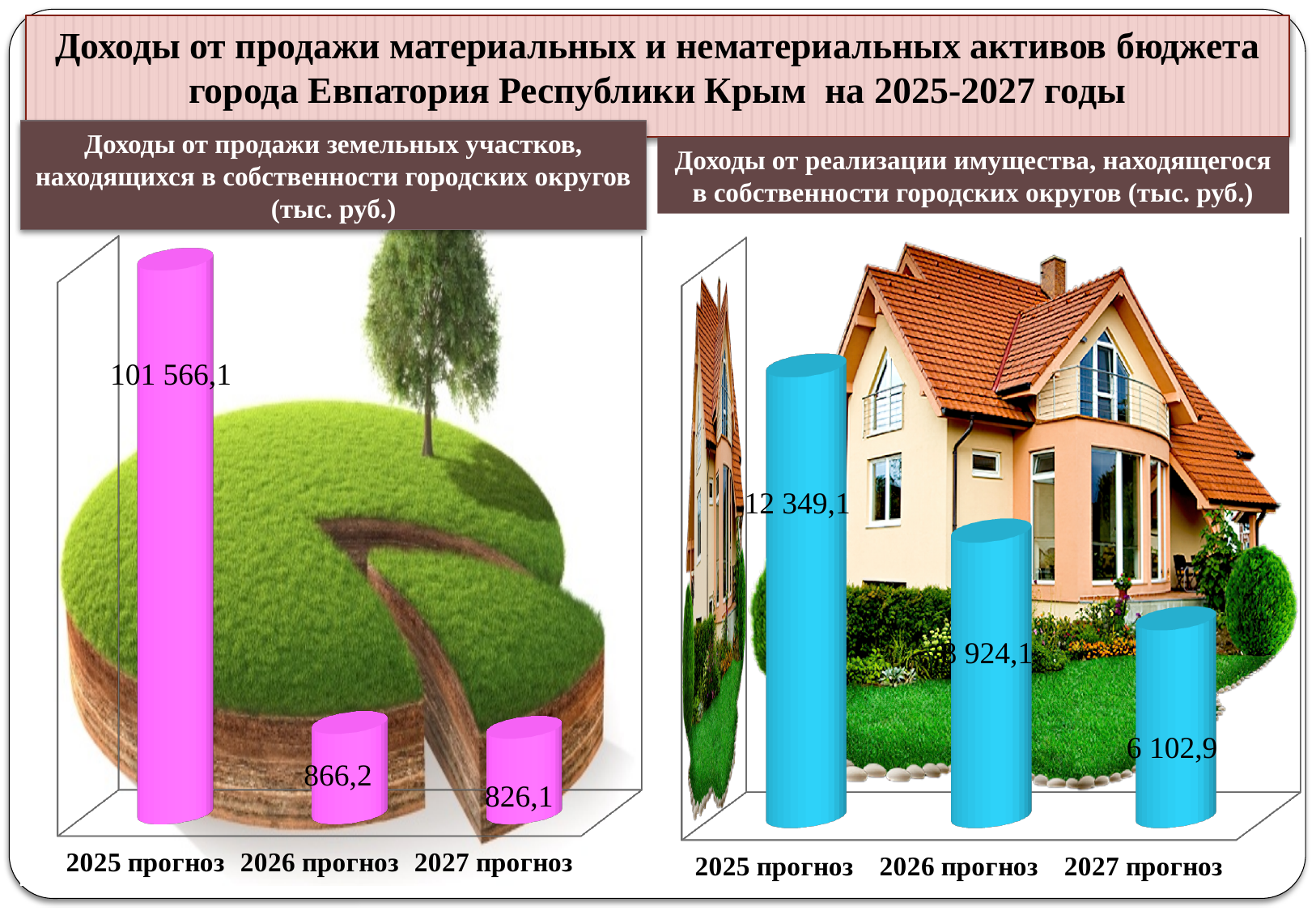
On the left chart (Доходы от продажи земельных участков), what is the value for 2026 прогноз? 866,2 On the right chart (Доходы от реализации имущества), what is the difference between the 2025 прогноз and 2027 прогноз values? 6 246,2 How many categories (years) are shown on the right chart (Доходы от реализации имущества)? 3 On the right chart (Доходы от реализации имущества), do the values rise or fall from 2025 to 2027? fall On the left chart (Доходы от продажи земельных участков), what is the value for 2025 прогноз? 101 566,1 On the right chart (Доходы от реализации имущества), what is the value for 2025 прогноз? 12 349,1 On the left chart (Доходы от продажи земельных участков), what is the difference between the 2026 прогноз and 2027 прогноз values? 40,1 On the right chart (Доходы от реализации имущества), what is the value for 2027 прогноз? 6 102,9 On the left chart (Доходы от продажи земельных участков), what is the value for 2027 прогноз? 826,1 On the left chart (Доходы от продажи земельных участков), which year has the lowest value? 2027 прогноз On the left chart (Доходы от продажи земельных участков), which year has the highest value? 2025 прогноз On the right chart (Доходы от реализации имущества), which year has the lowest value? 2027 прогноз